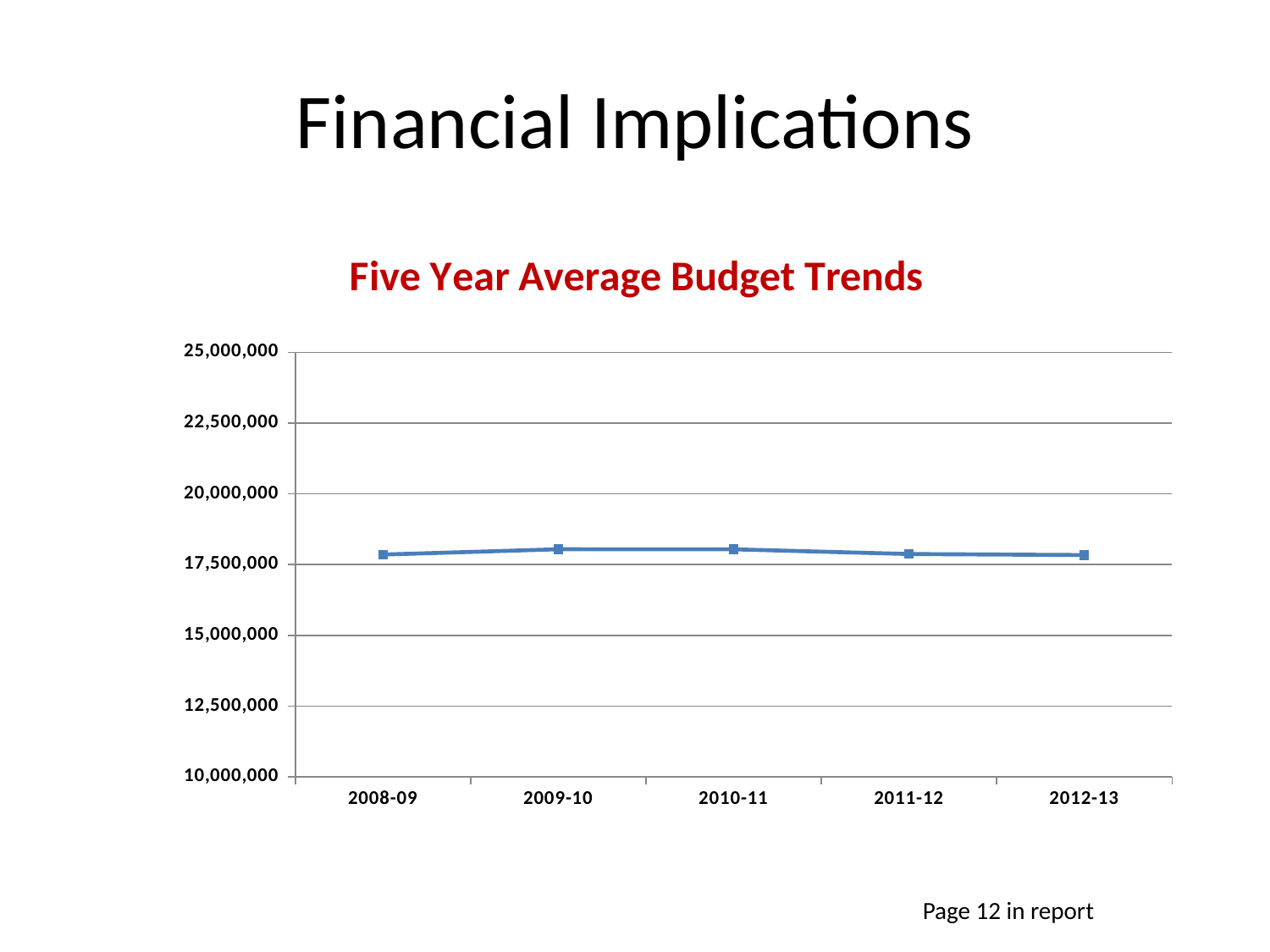
Is the value for 2011-12 greater or less than 12,500,000? greater What is the title of the chart on the slide? Five Year Average Budget Trends What kind of chart is shown on the slide? line chart How many lines (series) are plotted in the Five Year Average Budget Trends chart? 1 Is the value for 2008-09 greater or less than 20,000,000? less What is the highest value labelled on the y axis of the chart? 25,000,000 How many data points are plotted on the line in the Five Year Average Budget Trends chart? 5 Is the value for 2012-13 greater or less than 22,500,000? less What is the first year shown on the x axis of the chart? 2008-09